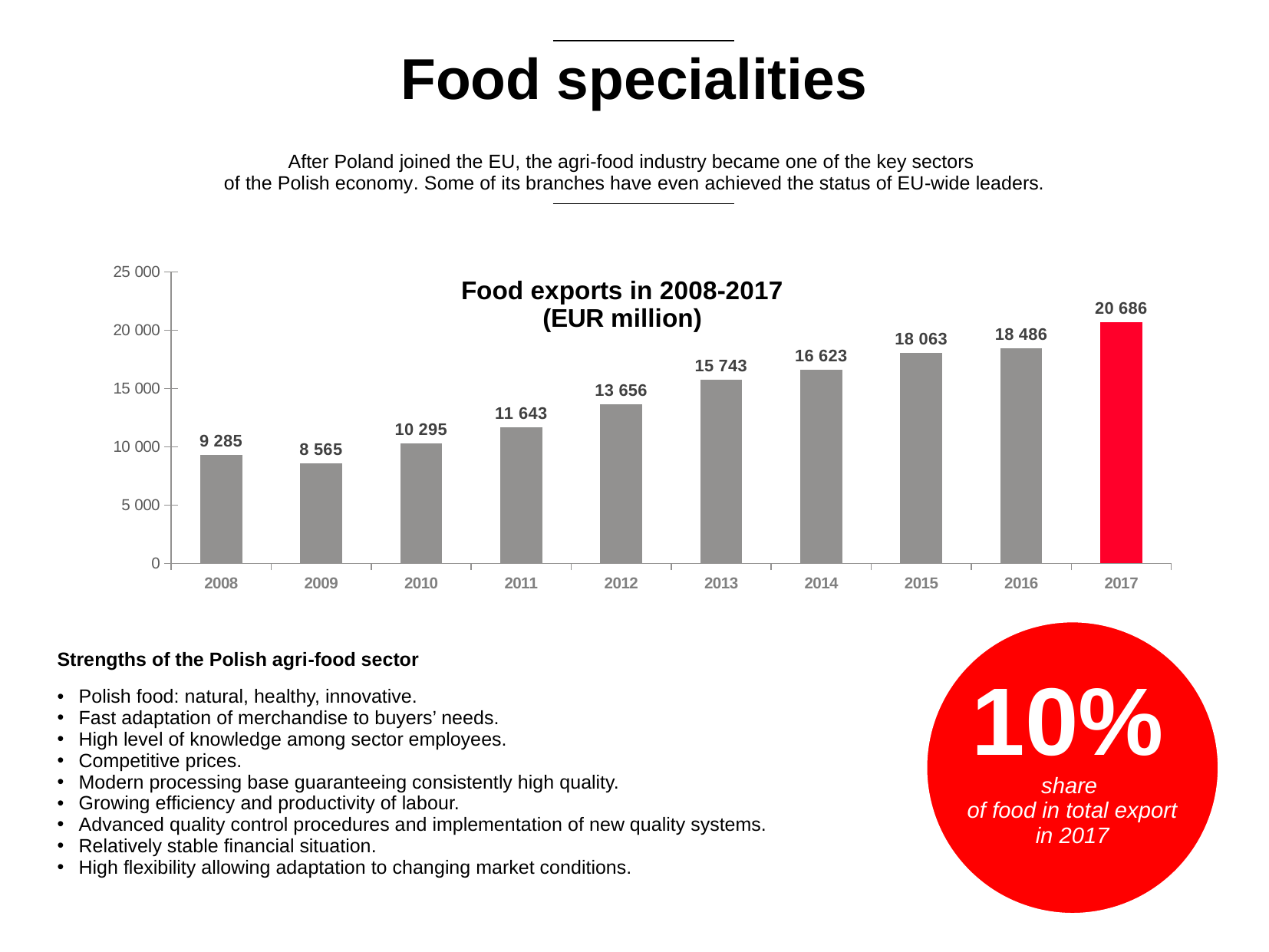
What is the title of the chart on the slide? Food exports in 2008-2017 (EUR million) How many years are shown on the x axis of the chart? 10 Which year had higher food exports, 2010 or 2011? 2011 What is the value of food exports in 2017 according to the chart? 20 686 What is the difference between food exports in 2008 and 2009? 720 Which year has the highest food exports in the chart? 2017 What is the value of food exports in 2009 according to the chart? 8 565 What is the difference between food exports in 2017 and 2016? 2 200 What is the value of food exports in 2013 according to the chart? 15 743 Which year has the lowest food exports in the chart? 2009 Is the value for 2014 greater or less than 15 000? greater What kind of chart is used to show food exports in 2008-2017? Bar chart